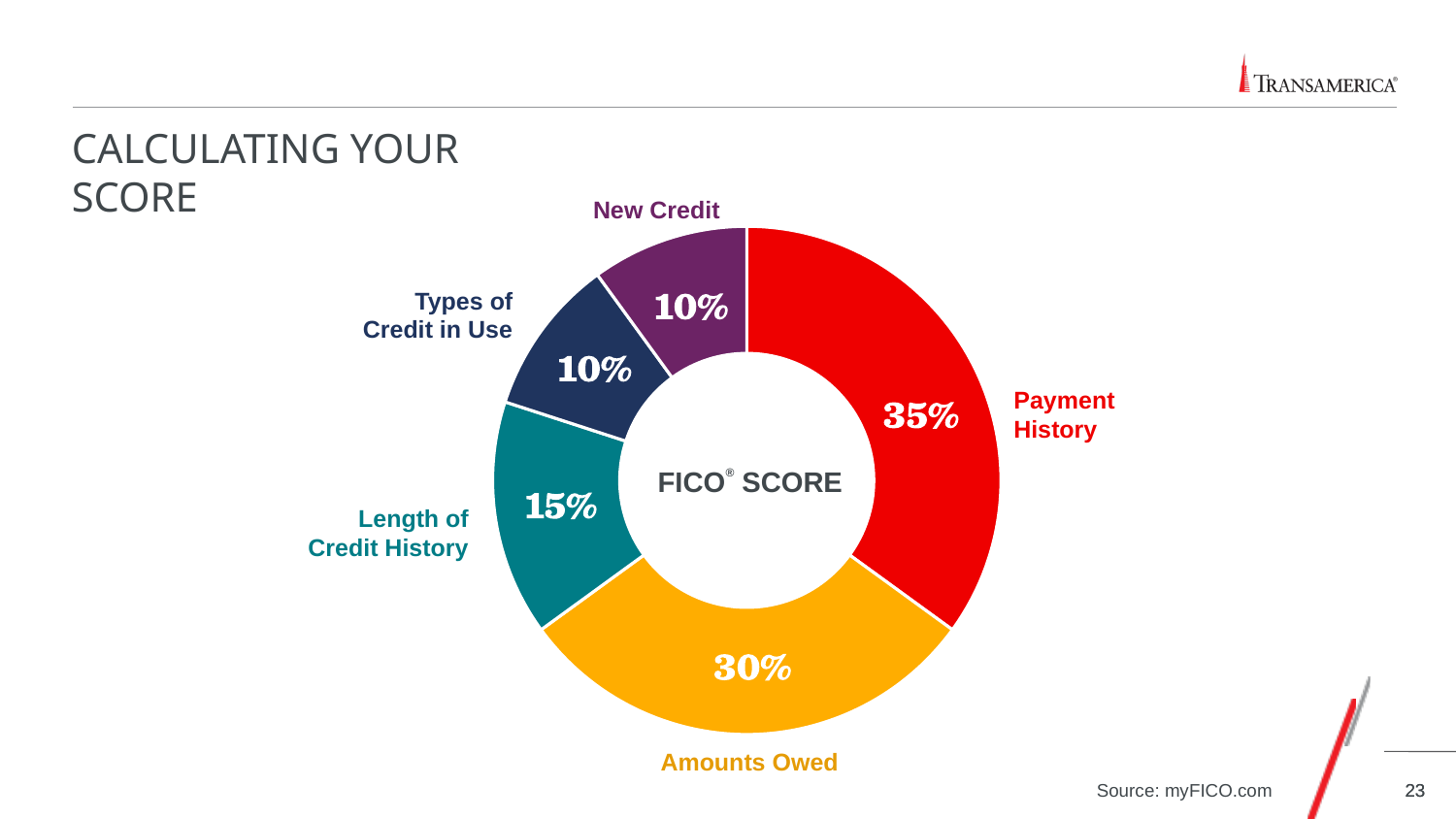
What text appears in the centre of the chart? FICO SCORE What percentage of the FICO Score does Amounts Owed account for? 30% What is the difference in percentage points between Payment History and Amounts Owed? 5 What percentage of the FICO Score does Payment History account for? 35% What kind of chart is shown on the slide? Doughnut chart What colour is the Amounts Owed segment? Orange Which is larger, the share for Length of Credit History or the share for Types of Credit in Use? Length of Credit History Which factor has the largest share of the FICO Score? Payment History What percentage of the FICO Score does New Credit account for? 10% What is the combined share of Payment History and Amounts Owed? 65% What percentage of the FICO Score does Length of Credit History account for? 15% How many factors are shown in the chart? 5